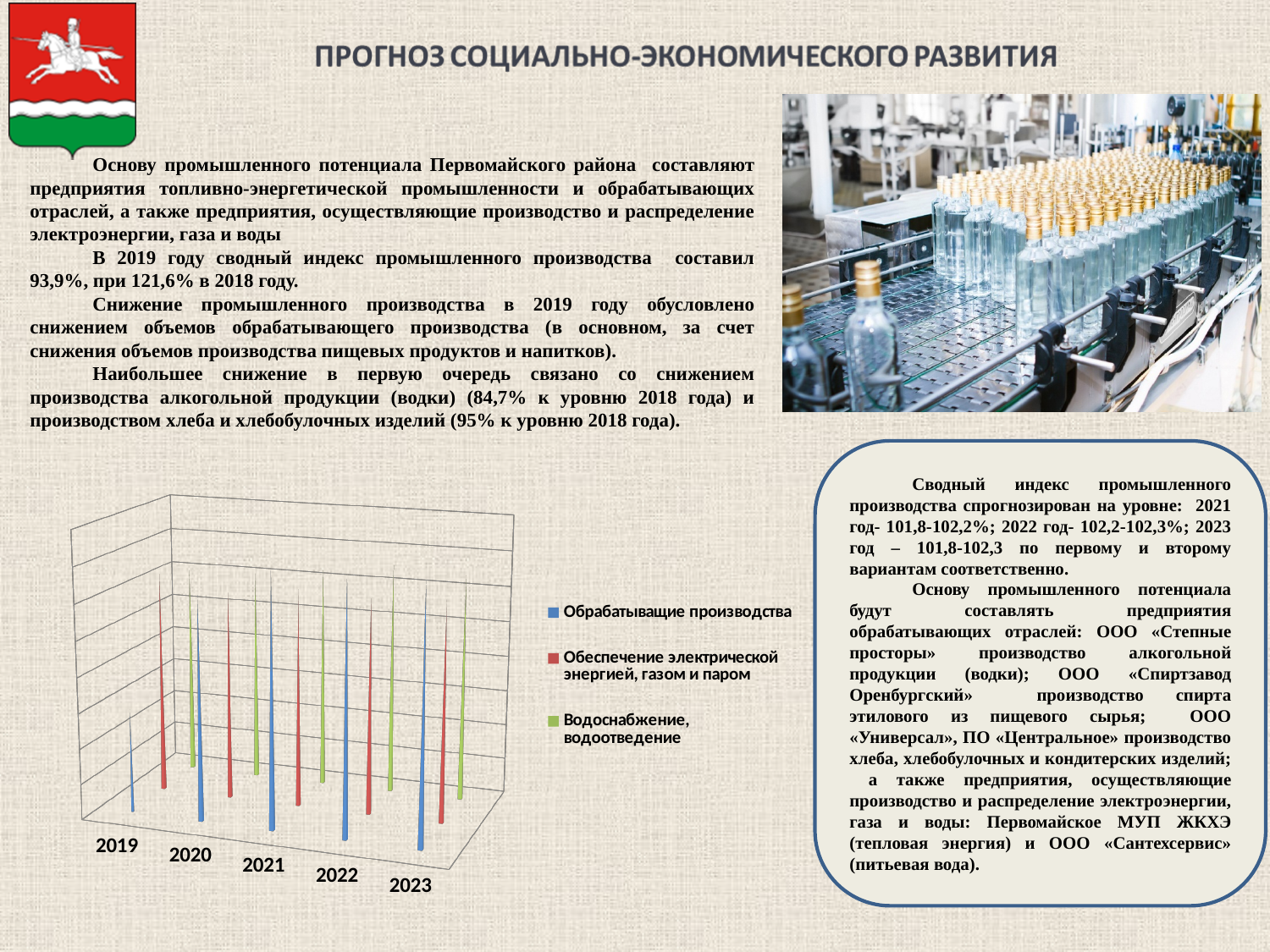
In 2019, which is larger: the value for Обрабатыващие производства or the value for Обеспечение электрической энергией, газом и паром? Обеспечение электрической энергией, газом и паром For Обрабатыващие производства, which year has the lowest value? 2019 How many years are shown on the x axis of the chart? 5 For Обрабатыващие производства, which is larger: the value for 2019 or the value for 2023? 2023 How many series does the chart legend list? 3 What kind of chart is shown on the slide? bar chart Do the values for Обрабатыващие производства rise or fall from 2019 to 2023? rise What is the last year shown on the x axis of the chart? 2023 What is the first year shown on the x axis of the chart? 2019 Which series is shown in blue in the chart legend? Обрабатыващие производства